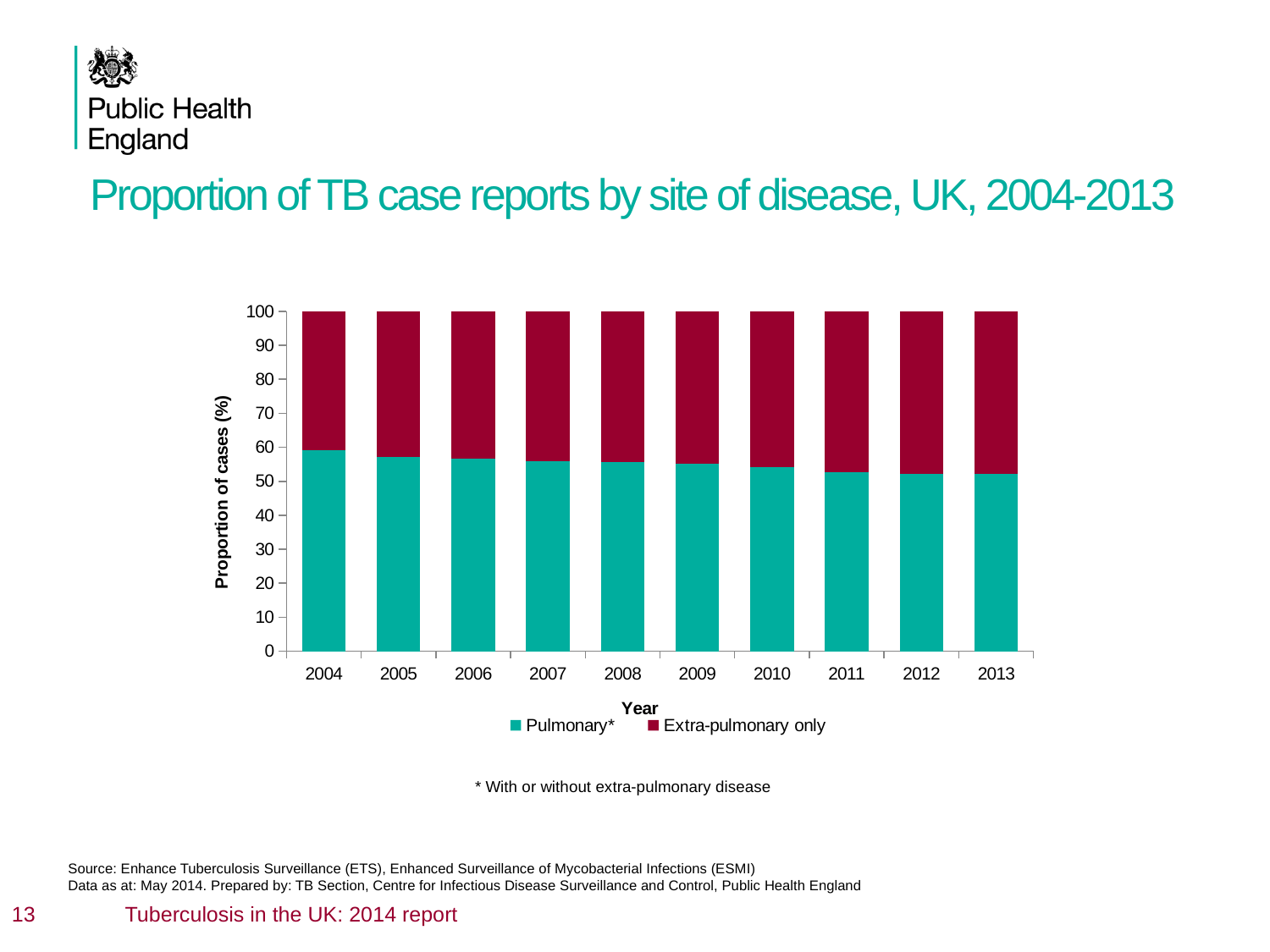
In which year is the Pulmonary* proportion highest? 2004 Is the Pulmonary* proportion in 2013 greater or less than 60? less What is the title of the chart? Proportion of TB case reports by site of disease, UK, 2004-2013 What is the label of the y axis? Proportion of cases (%) How many years are shown on the x axis of the chart? 10 How many series does the legend list? 2 Is the Extra-pulmonary only proportion in 2004 greater or less than 50? less Does the Pulmonary* proportion rise or fall from 2004 to 2013? fall Which is larger, the Pulmonary* proportion in 2004 or in 2013? 2004 Is the Pulmonary* proportion in 2004 greater or less than 50? greater What kind of chart is shown on the slide? stacked bar chart What is the total height of the stacked bar for 2004? 100